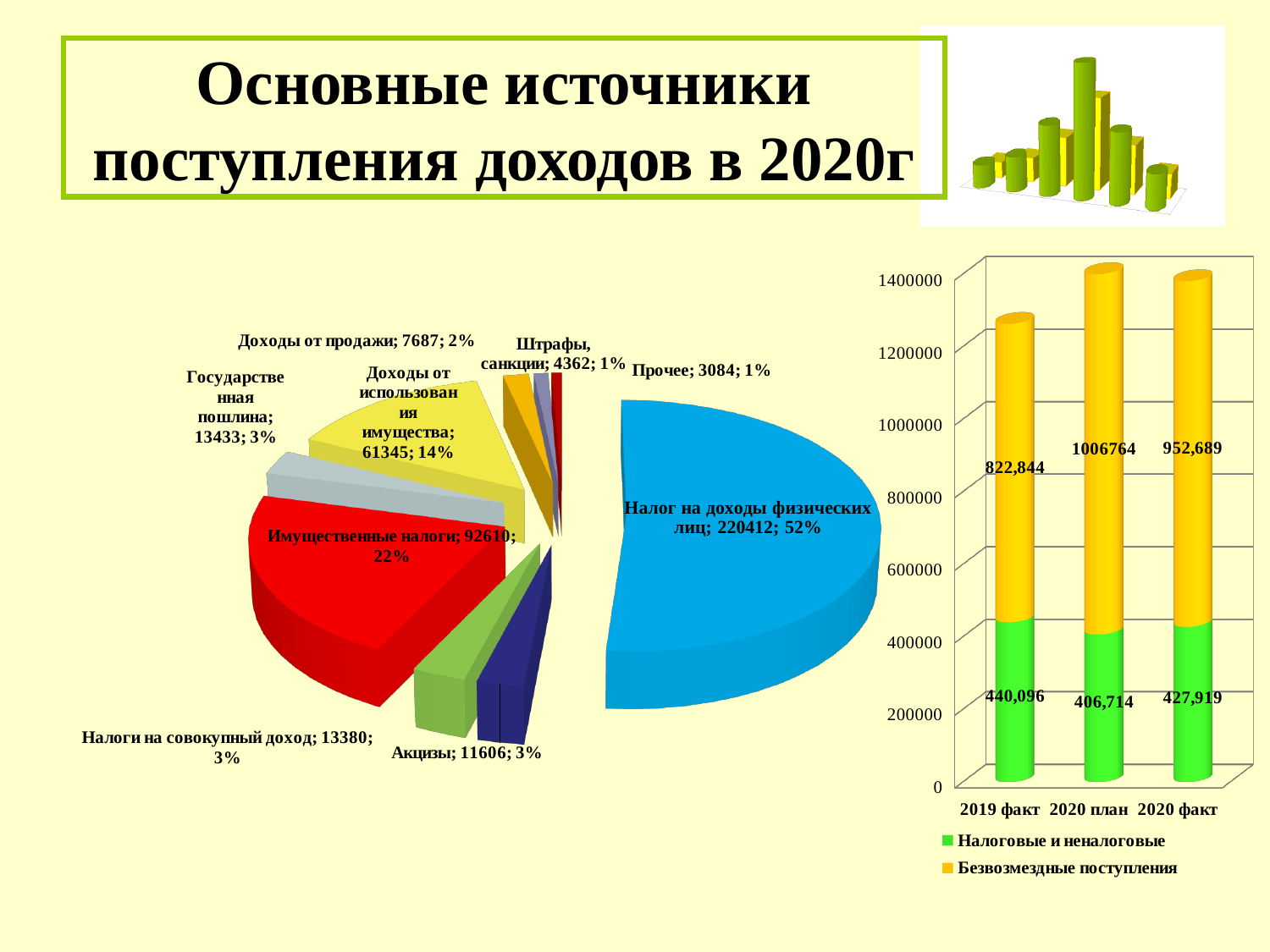
On the pie chart, what is the difference between the values for Налог на доходы физических лиц and Имущественные налоги? 127802 On the bar chart on the right, what is the value of Безвозмездные поступления for 2020 план? 1006764 On the pie chart, which is larger: Доходы от использования имущества or Государственная пошлина? Доходы от использования имущества On the pie chart, how many slices are there? 9 On the pie chart, what share does Имущественные налоги have? 22% On the bar chart on the right, how many series does the legend list? 2 What kind of chart is shown on the right side of the slide? Stacked bar chart On the bar chart on the right, what is the value of Налоговые и неналоговые for 2019 факт? 440,096 On the pie chart, what value and share are shown for Налог на доходы физических лиц? 220412; 52% On the bar chart on the right, what is the total of the stacked bar for 2019 факт? 1,262,940 On the pie chart, which category has the largest slice? Налог на доходы физических лиц On the pie chart, which category has the smallest value? Прочее